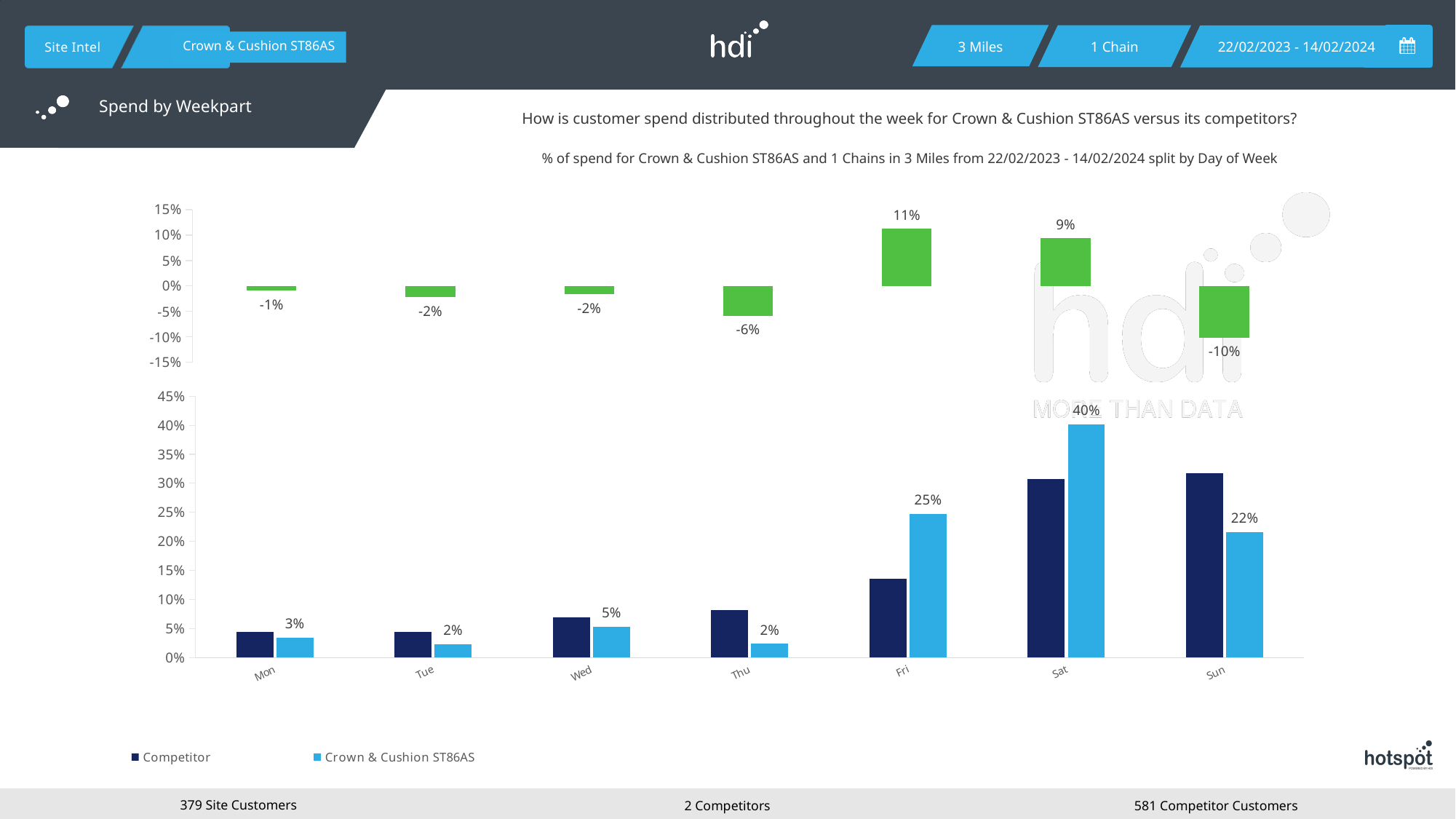
What kind of chart is the bottom chart? Bar chart In the top chart (green bars), which day has the lowest value? Sun In the bottom chart, what is the difference between the Crown & Cushion ST86AS values for Sat and Fri? 15% In the top chart (green bars), what is the value for Fri? 11% In the top chart (green bars), what is the difference between the values for Fri and Sat? 2% How many series does the legend of the bottom chart list? 2 In the bottom chart, on Sun, which series has the larger value: Competitor or Crown & Cushion ST86AS? Competitor In the bottom chart, on which day is the Crown & Cushion ST86AS value highest? Sat In the top chart (green bars), which day has the highest value? Fri In the bottom chart, is the Competitor value for Sat greater or less than 25%? greater How many days of the week are shown on the x axis of the bottom chart? 7 In the bottom chart, what is the value for Crown & Cushion ST86AS on Sat? 40%